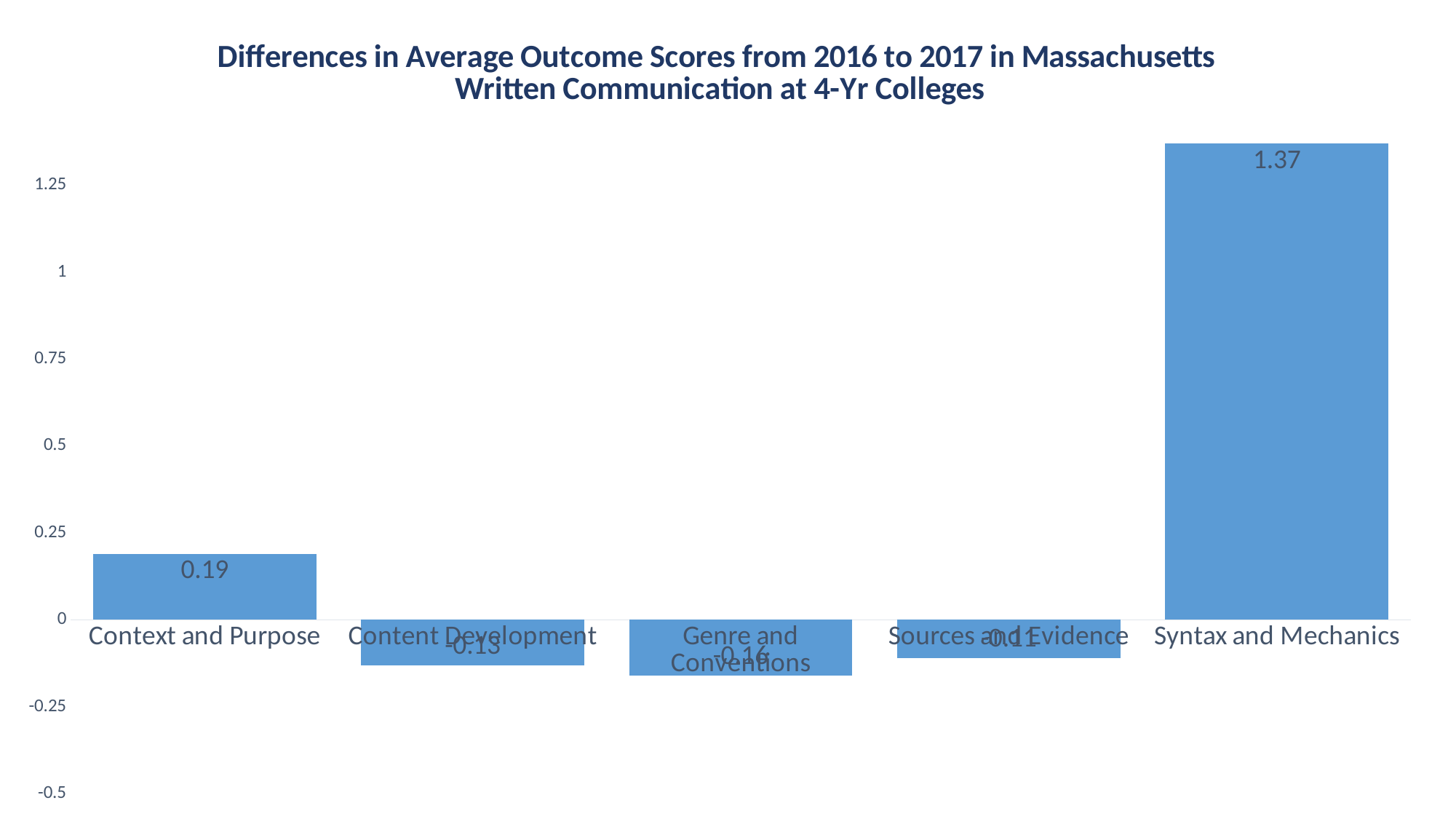
Is the value for Content Development greater or less than -0.25? greater Which is larger, the value for Syntax and Mechanics or the value for Context and Purpose? Syntax and Mechanics How many categories have a negative value? 3 Is the value for Genre and Conventions greater or less than 0? less What is the value for Context and Purpose? 0.19 How many categories are shown on the chart? 5 What kind of chart is shown on the slide? bar chart Is the value for Syntax and Mechanics greater or less than 1? greater Which category has the highest value? Syntax and Mechanics What is the value for Syntax and Mechanics? 1.37 What is the difference between the values for Syntax and Mechanics and Context and Purpose? 1.18